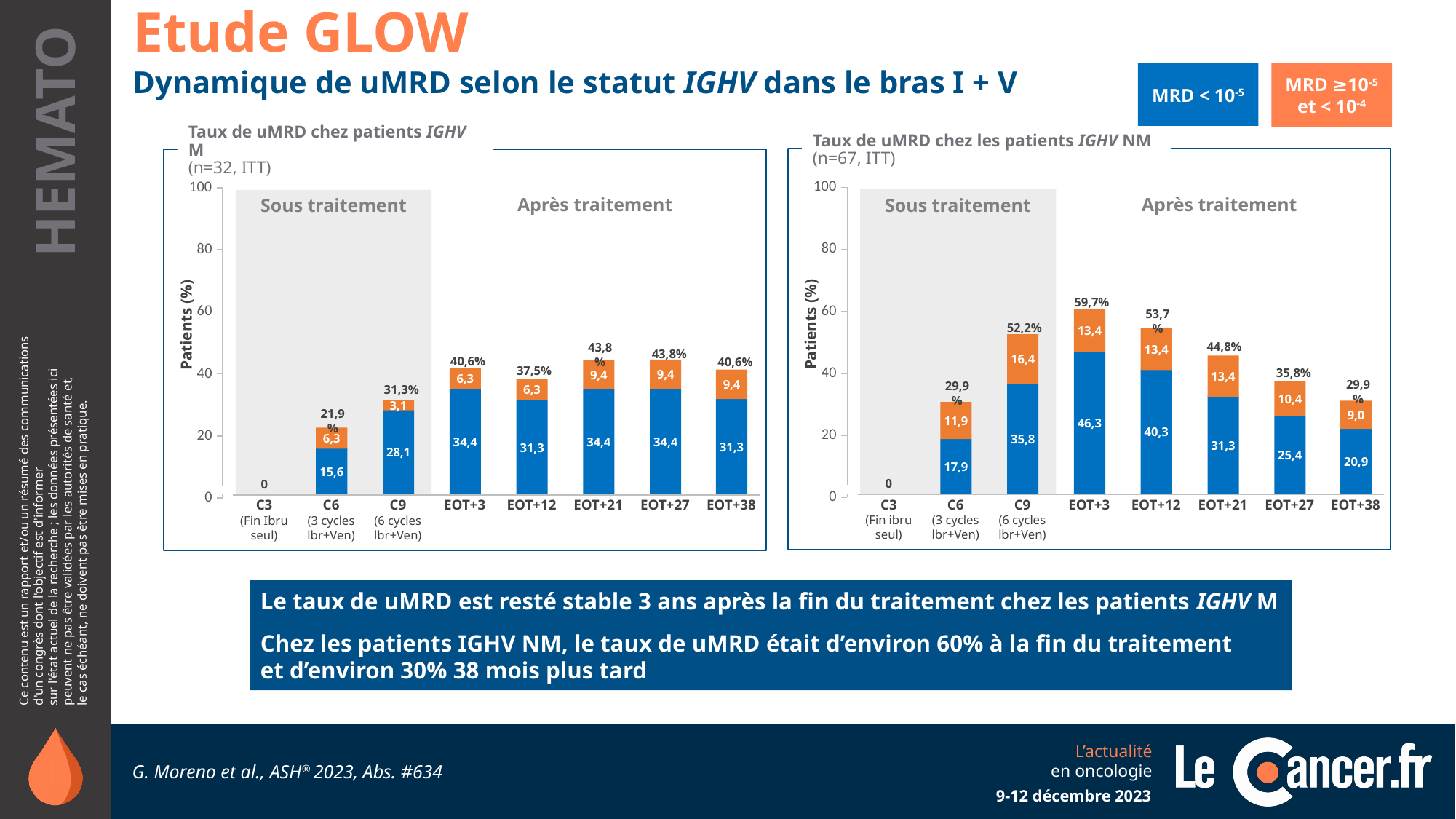
How many series does the legend list for the charts? 2 How many time points are shown on the x axis of the left chart (IGHV M patients)? 8 In the right chart (IGHV NM patients), what is the orange MRD ≥10^-5 et < 10^-4 value at C9? 16,4 Is the total uMRD rate at EOT+12 in the right chart (IGHV NM patients) larger than at EOT+12 in the left chart (IGHV M patients)? Yes, right chart (53,7% vs 37,5%) In the right chart (IGHV NM patients), do the total uMRD rates rise or fall from EOT+3 to EOT+38? Fall In the right chart (IGHV NM patients), what is the difference between the total uMRD rate at EOT+3 and at EOT+38? 29,8% In the left chart (IGHV M patients), what is the total of the stacked bar at C6? 21,9% In the right chart (IGHV NM patients), which time point has the highest total uMRD rate? EOT+3 In the right chart (IGHV NM patients), what is the total uMRD rate labelled at EOT+3? 59,7% In the left chart (IGHV M patients), what is the blue MRD < 10^-5 value at EOT+3? 34,4 What kind of chart is used for the IGHV NM patients (right chart)? Stacked bar chart In the left chart (IGHV M patients), which time point has the lowest total uMRD rate? C3